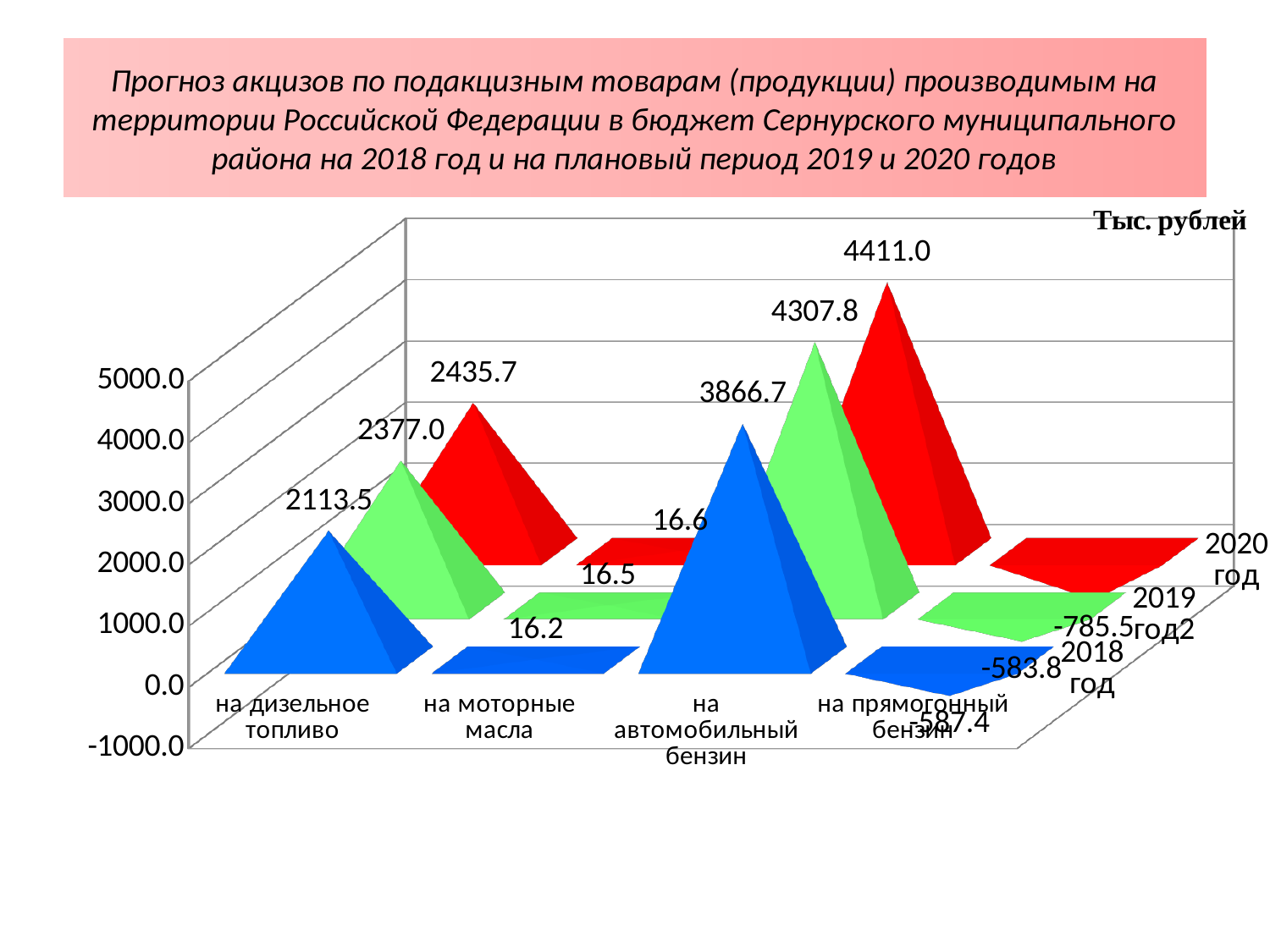
Which category has the highest value in 2019 год? на автомобильный бензин Is the value for 'на прямогонный бензин' in 2018 год greater or less than 0.0? less How many series (years) does the chart show? 3 Which category has the lowest value in 2018 год? на прямогонный бензин What is the value for 'на моторные масла' in 2019 год? 16.5 What is the value for 'на дизельное топливо' in 2020 год? 2435.7 Which is larger: the 2019 год value for 'на дизельное топливо' or the 2019 год value for 'на моторные масла'? на дизельное топливо What is the value for 'на дизельное топливо' in 2018 год? 2113.5 What is the difference between the 2020 год and 2018 год values for 'на автомобильный бензин'? 544.3 What is the forecast value for 'на автомобильный бензин' in 2020 год? 4411.0 What unit of measurement is indicated on the chart? Тыс. рублей How many product categories are shown on the x axis? 4